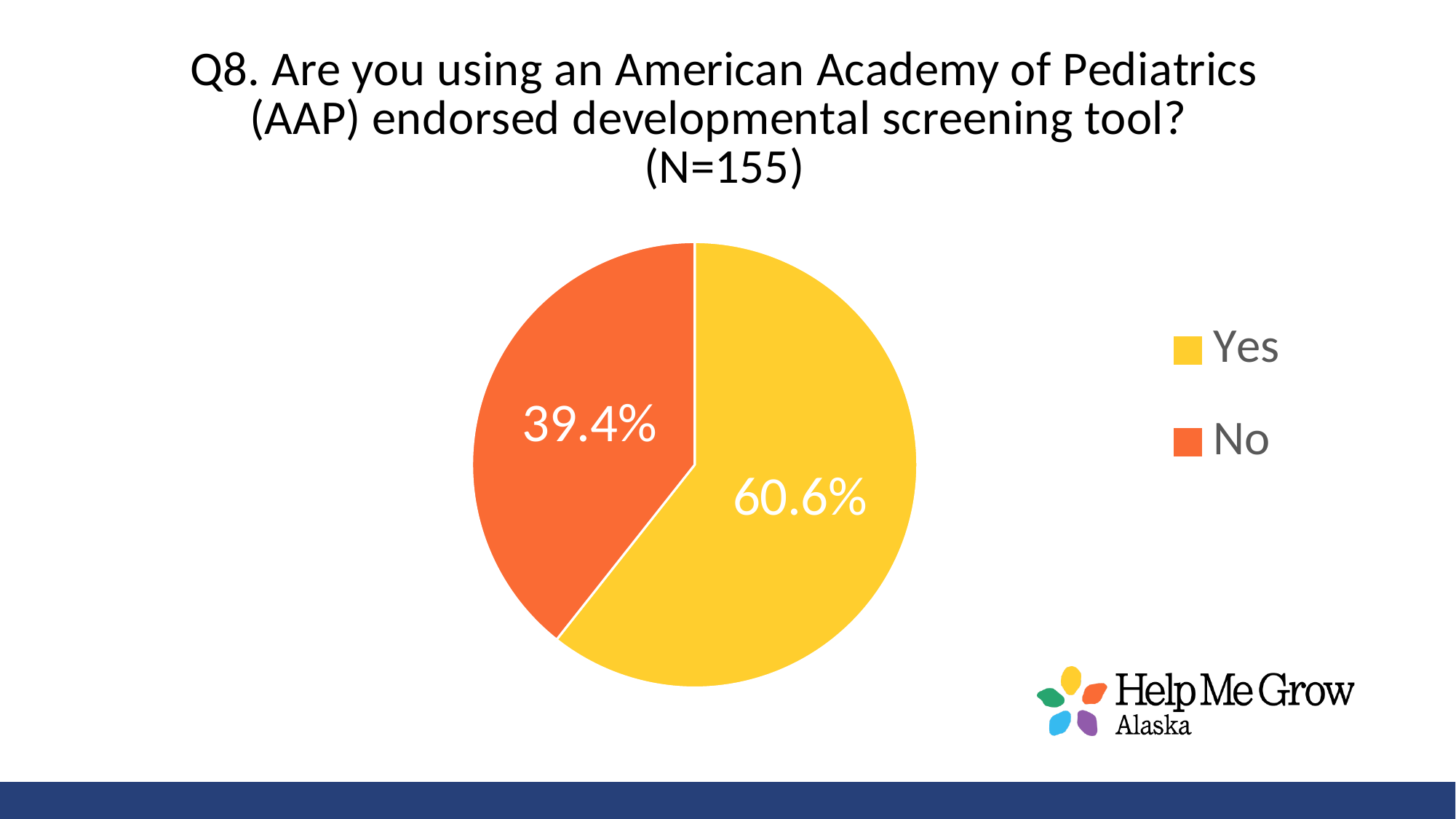
How many slices does the pie chart have? 2 Which response has the smallest share of the pie? No Which response has the largest share of the pie? Yes What is the difference in percentage points between the Yes and No shares? 21.2 Which is larger, the share for Yes or the share for No? Yes What share of the pie does the Yes slice represent? 60.6% What is the sample size (N) stated in the chart title? 155 What colour is the slice for No? Orange How many entries does the legend list? 2 What percentage of respondents answered Yes? 60.6% What kind of chart is shown on the slide? Pie chart What percentage of respondents answered No? 39.4%